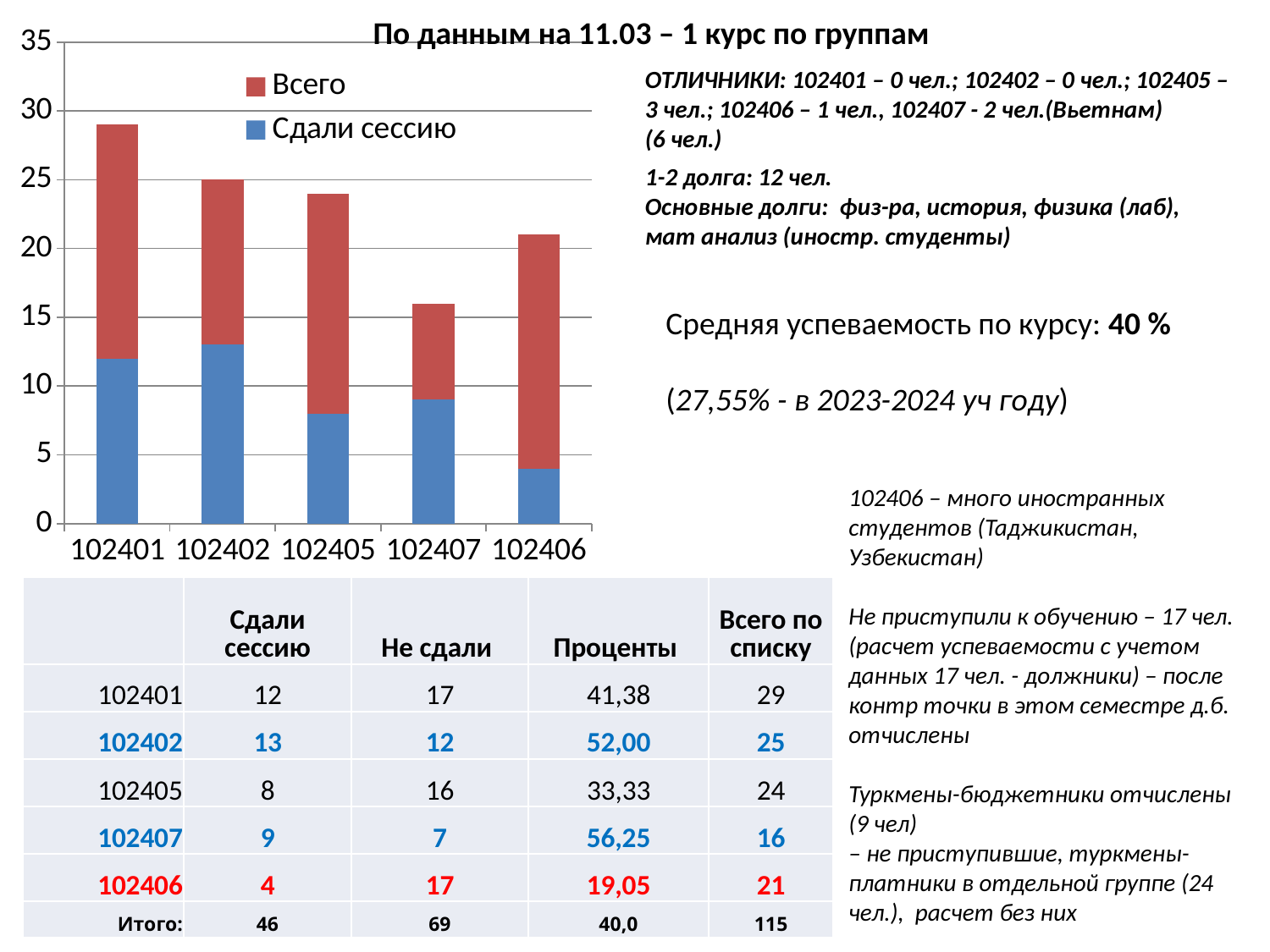
Which group has the smallest blue 'Сдали сессию' segment? 102406 What kind of chart is shown on the slide? Stacked bar chart Which bar is taller, 102405 or 102406? 102405 What is the total height of the bar for group 102402? 25 What are the two entries in the chart legend? Всего and Сдали сессию Is the total bar height for group 102401 greater or less than 25? greater Which group has the shortest bar in the chart? 102407 What is the value of the 'Сдали сессию' segment for group 102401? 12 Which group has the tallest bar in the chart? 102401 Is the total bar height for group 102407 greater or less than 20? less How many series does the chart legend list? 2 How many groups (categories) are plotted on the x axis of the chart? 5